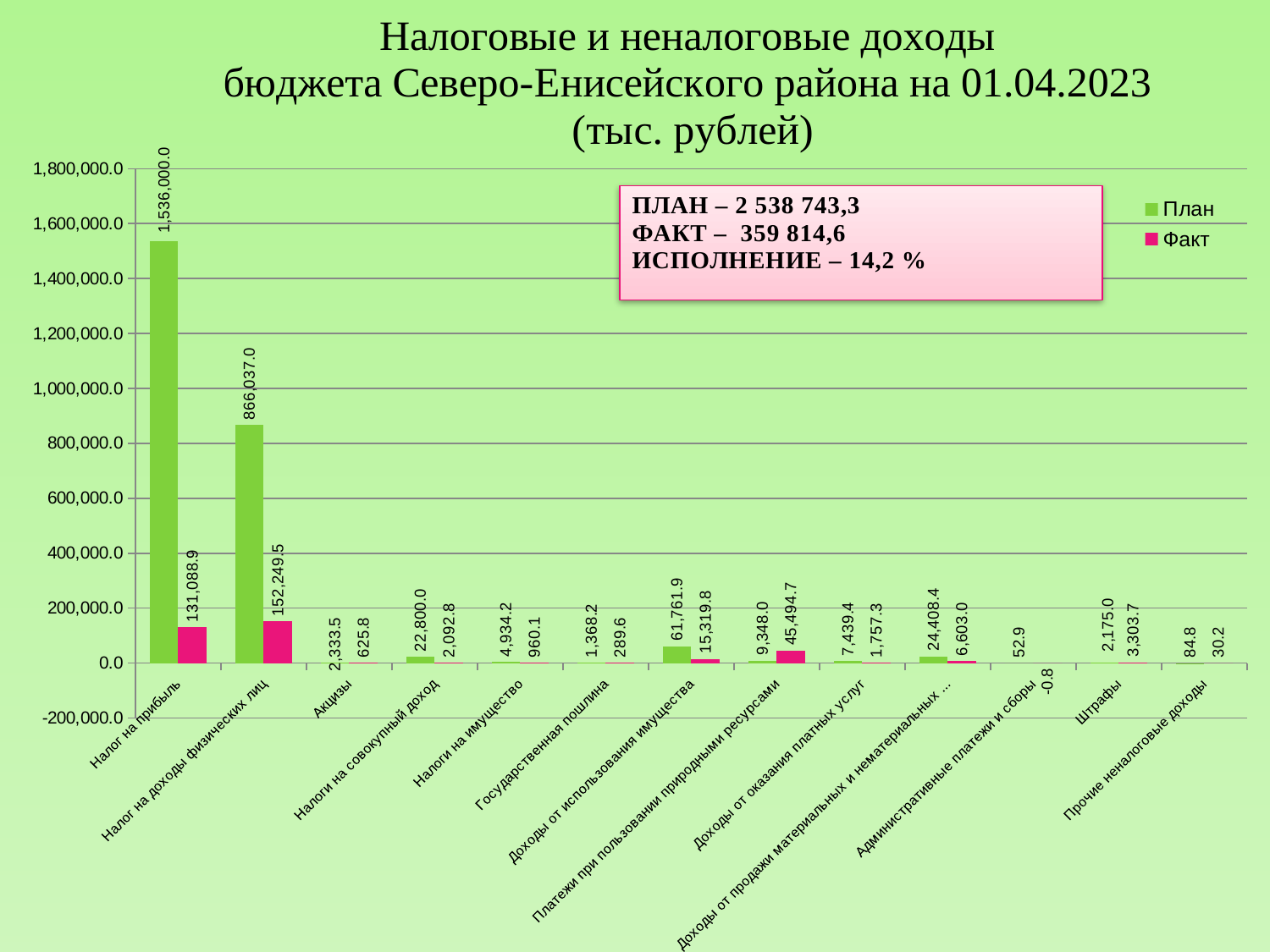
Which category has the lowest Факт value? Административные платежи и сборы What kind of chart is shown on the slide? Bar chart What is the Факт value for Платежи при пользовании природными ресурсами? 45,494.7 Which category has the highest Факт value? Налог на доходы физических лиц For Штрафы, which is larger: the План value or the Факт value? Факт What is the Факт value for Налог на доходы физических лиц? 152,249.5 How many categories are shown on the x axis? 13 What is the План value for Налог на прибыль? 1,536,000.0 How many series does the legend list? 2 What is the План value for Доходы от использования имущества? 61,761.9 Which category has the highest План value? Налог на прибыль What is the difference between the План and Факт values for Налог на прибыль? 1,404,911.1